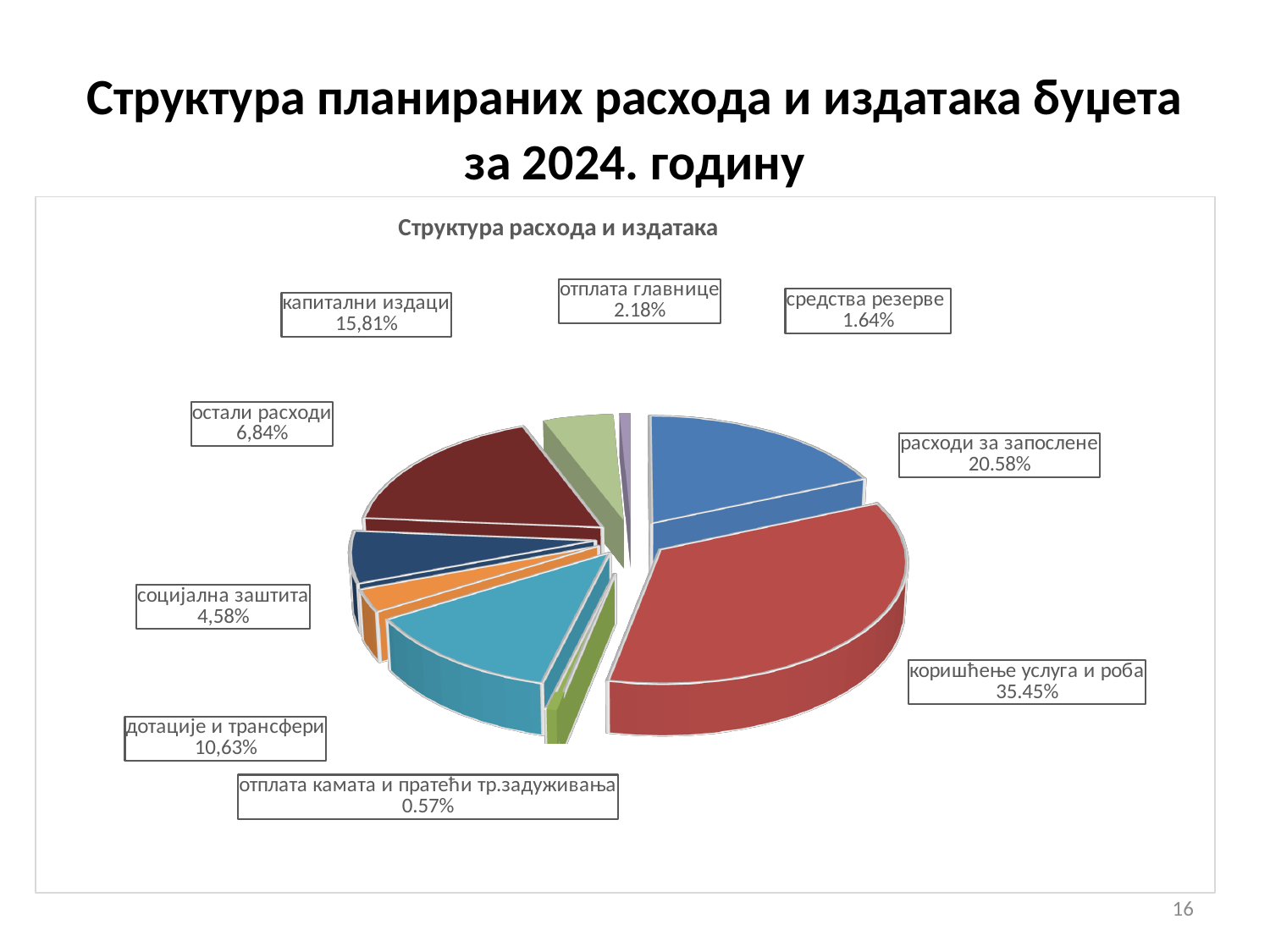
What is the value shown for капитални издаци? 15,81% Which is larger, остали расходи or социјална заштита? остали расходи What share of the pie does коришћење услуга и роба have? 35.45% What type of chart is shown on the slide? pie chart What is the value shown for расходи за запослене? 20.58% What is the value shown for средства резерве? 1.64% What is the difference between the shares of коришћење услуга и роба and расходи за запослене? 14.87% How many slices does the pie chart have? 9 Which category has the smallest share of the pie? отплата камата и пратећи тр.задуживања What is the title of the chart? Структура расхода и издатака Which category has the largest share of the pie? коришћење услуга и роба What is the value shown for дотације и трансфери? 10,63%